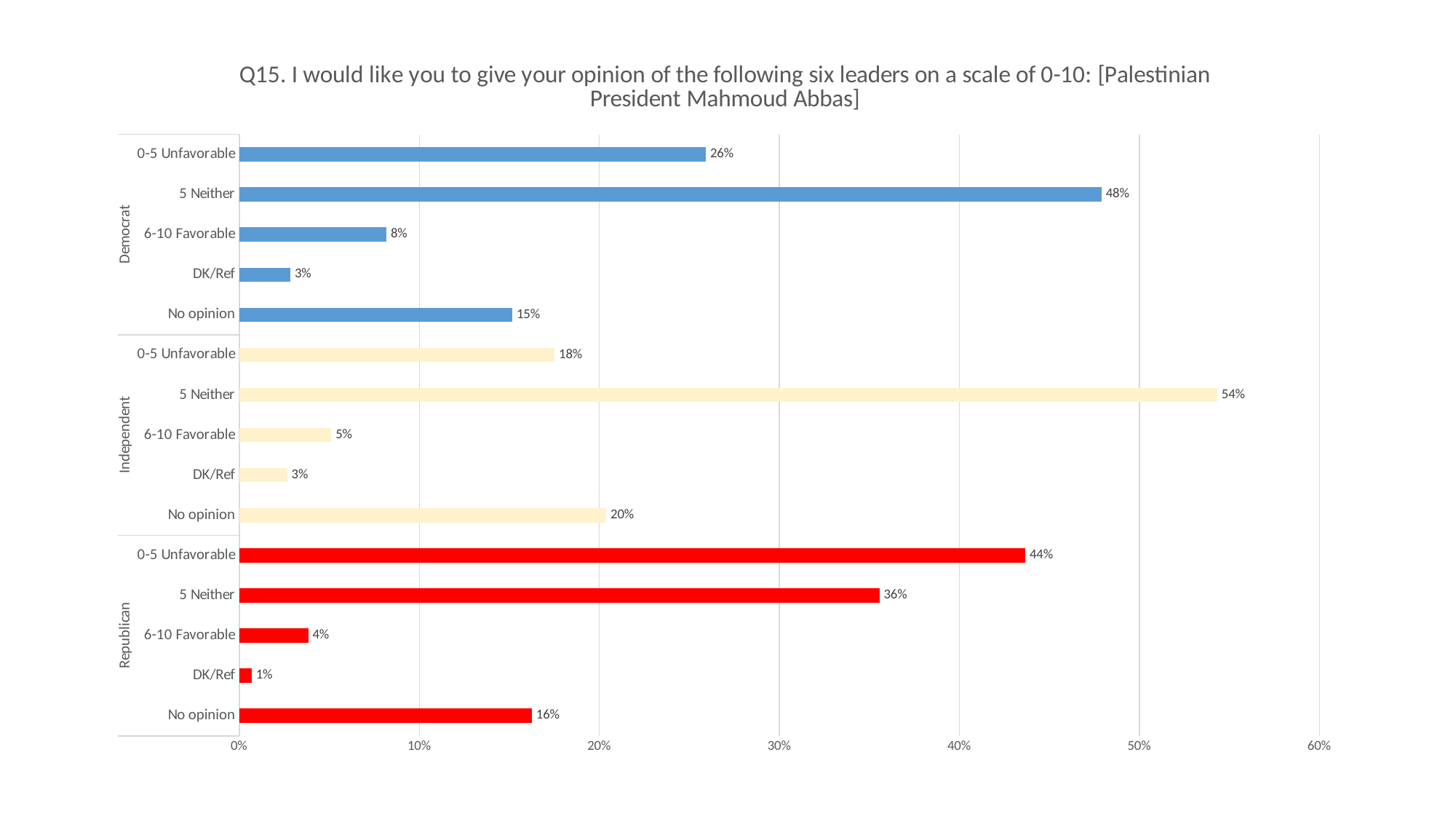
Which is larger: the Democrat '6-10 Favorable' value or the Independent '6-10 Favorable' value? Democrat 6-10 Favorable What type of chart is shown on the slide? Bar chart Is the Republican '5 Neither' value greater or less than 30%? greater What is the difference between the Independent '5 Neither' value and the Republican '5 Neither' value? 18% What is the 'No opinion' value for Independents? 20% What percentage of Democrats rated Mahmoud Abbas '5 Neither'? 48% What colour are the bars for the Republican group? Red What is the difference between the Republican '0-5 Unfavorable' value and the Democrat '0-5 Unfavorable' value? 18% Which bar on the chart has the lowest value? Republican DK/Ref How many bars are plotted on the chart in total? 15 What percentage of Republicans gave a '0-5 Unfavorable' rating? 44% Which bar on the chart has the highest value? Independent 5 Neither